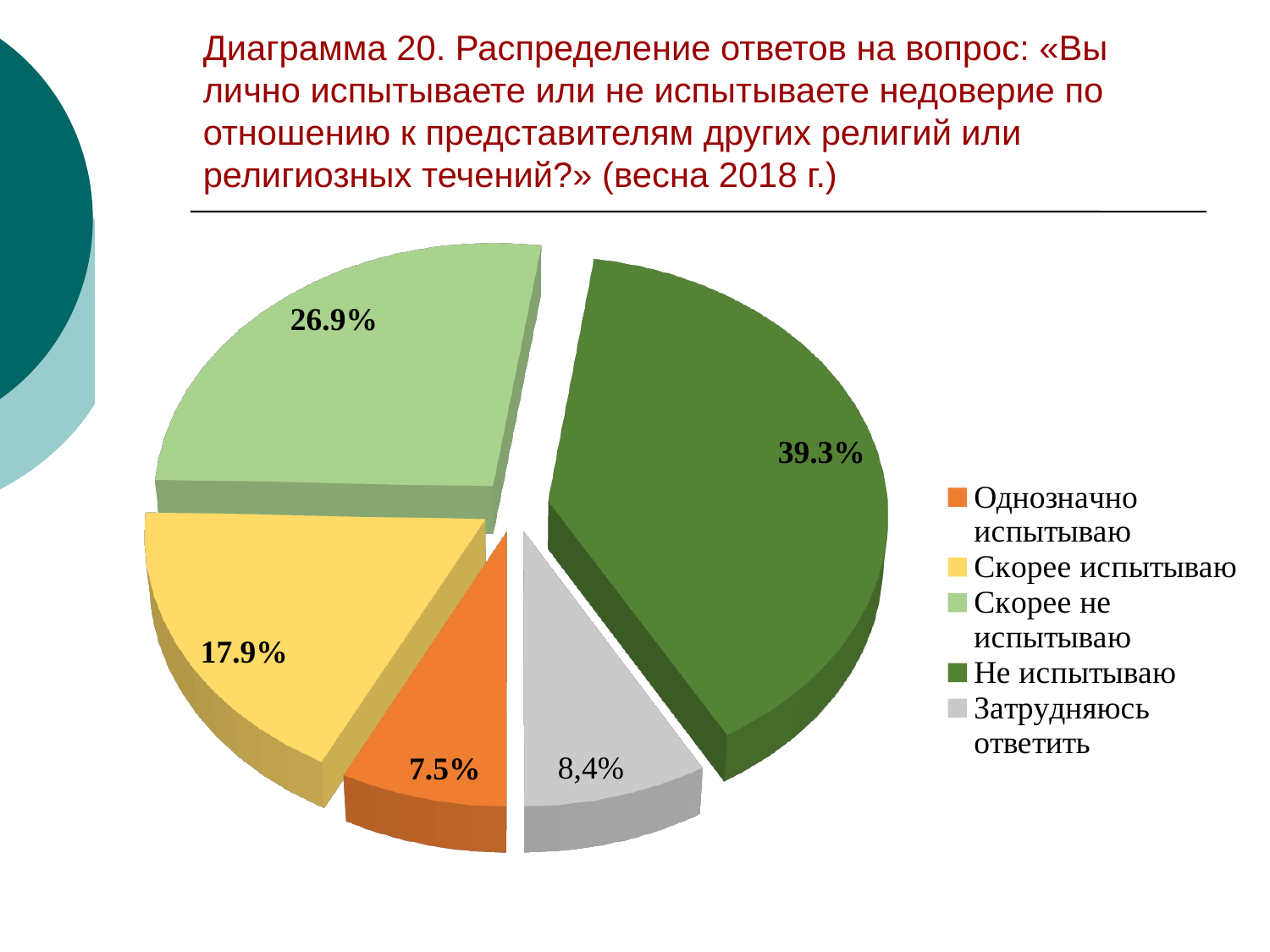
What share of respondents answered «Затрудняюсь ответить»? 8,4% What share of respondents answered «Скорее не испытываю»? 26.9% Which is larger: the share for «Скорее испытываю» or the share for «Затрудняюсь ответить»? Скорее испытываю Which answer option has the smallest share of the pie? Однозначно испытываю What share of respondents answered «Однозначно испытываю»? 7.5% What share of respondents answered «Не испытываю»? 39.3% How many answer categories does the pie chart show? 5 Which answer option has the largest share of the pie? Не испытываю What share of respondents answered «Скорее испытываю»? 17.9% What colour is the slice for «Однозначно испытываю»? orange What type of chart is shown on the slide? pie chart What is the difference in percentage points between «Не испытываю» and «Скорее не испытываю»? 12.4